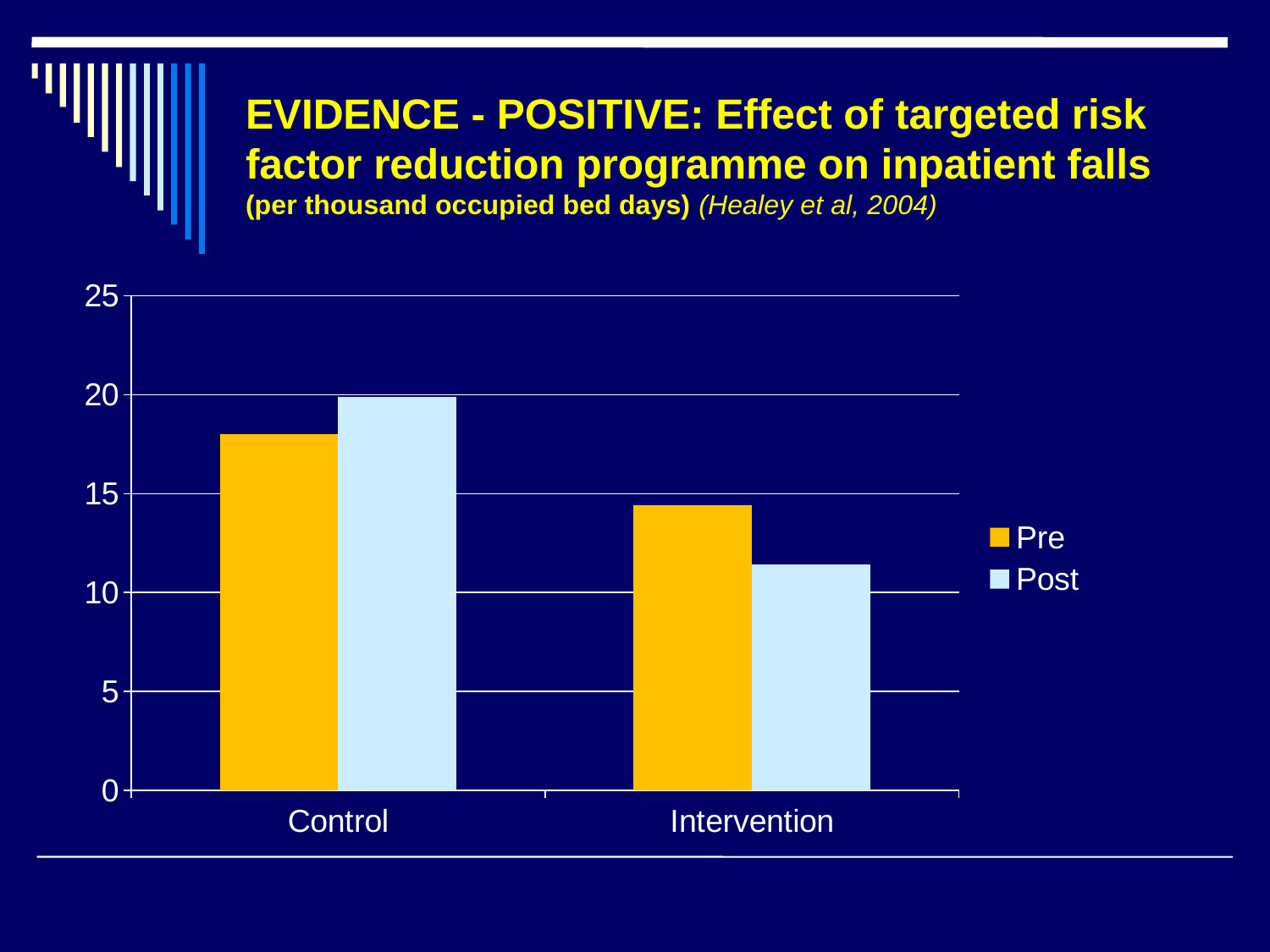
Which series is shown in light blue? Post Is the Pre value for Intervention greater or less than 10? greater Is the Post value for Intervention greater or less than 10? greater Is the Post value for Intervention greater or less than 15? less Which category has the lowest Post value? Intervention How many categories are shown on the x axis? 2 How many series does the legend list? 2 What kind of chart is shown on the slide? bar chart For Intervention, which is larger, the Pre value or the Post value? Pre For Control, which is larger, the Pre value or the Post value? Post